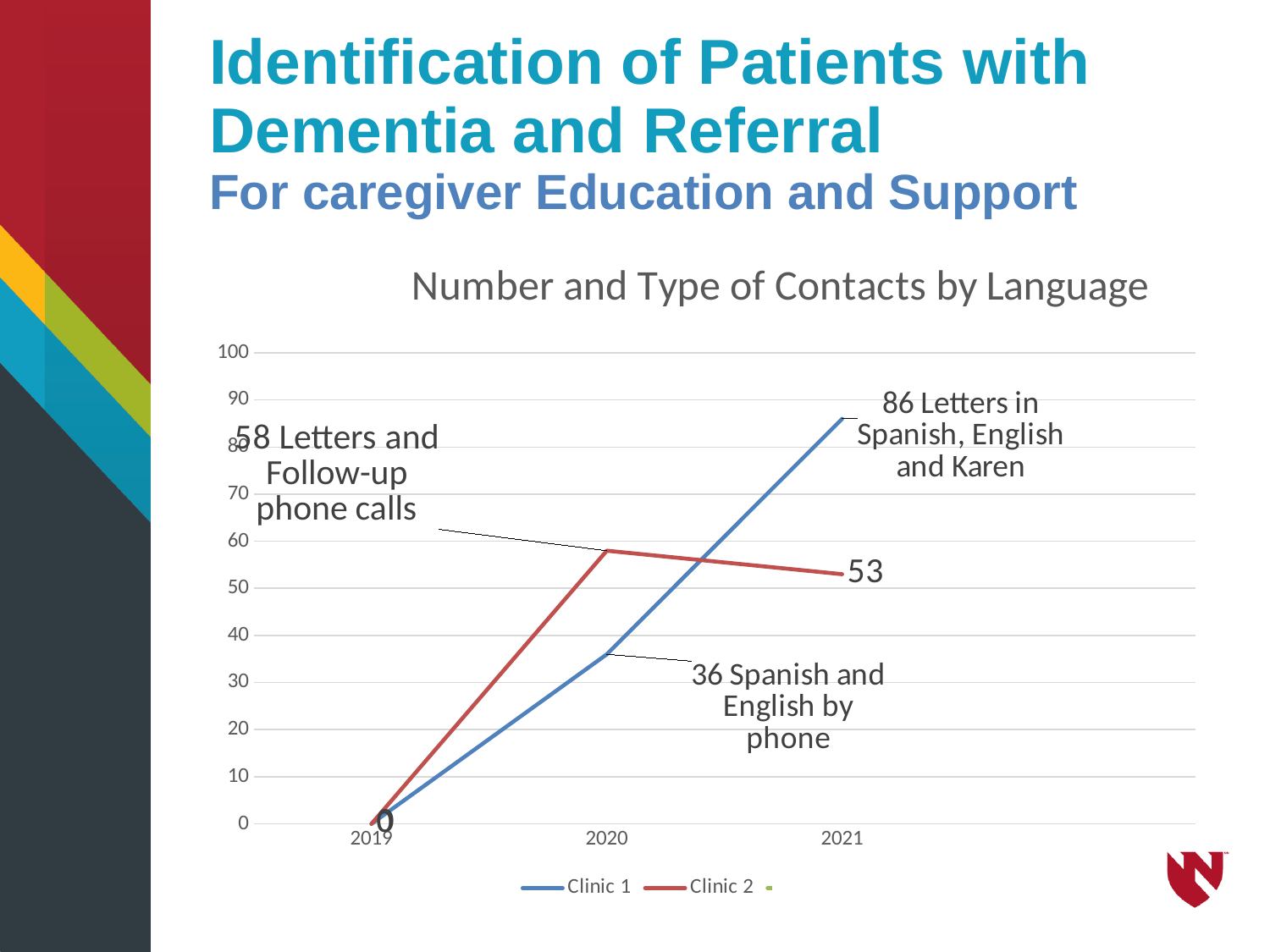
What is the value for Clinic 2 in 2021? 53 What is the value for Clinic 1 in 2019? 0 What is the value for Clinic 2 in 2020? 58 What is the difference between Clinic 2 and Clinic 1 in 2020? 22 In 2020, which clinic has the higher value, Clinic 1 or Clinic 2? Clinic 2 What is the value for Clinic 1 in 2020? 36 Does the value for Clinic 2 rise or fall from 2020 to 2021? Fall What is the value for Clinic 1 in 2021? 86 How many years are shown on the x axis? 3 What is the difference between Clinic 1 and Clinic 2 in 2021? 33 In 2021, which clinic has the higher value, Clinic 1 or Clinic 2? Clinic 1 What kind of chart is shown on the slide? Line chart